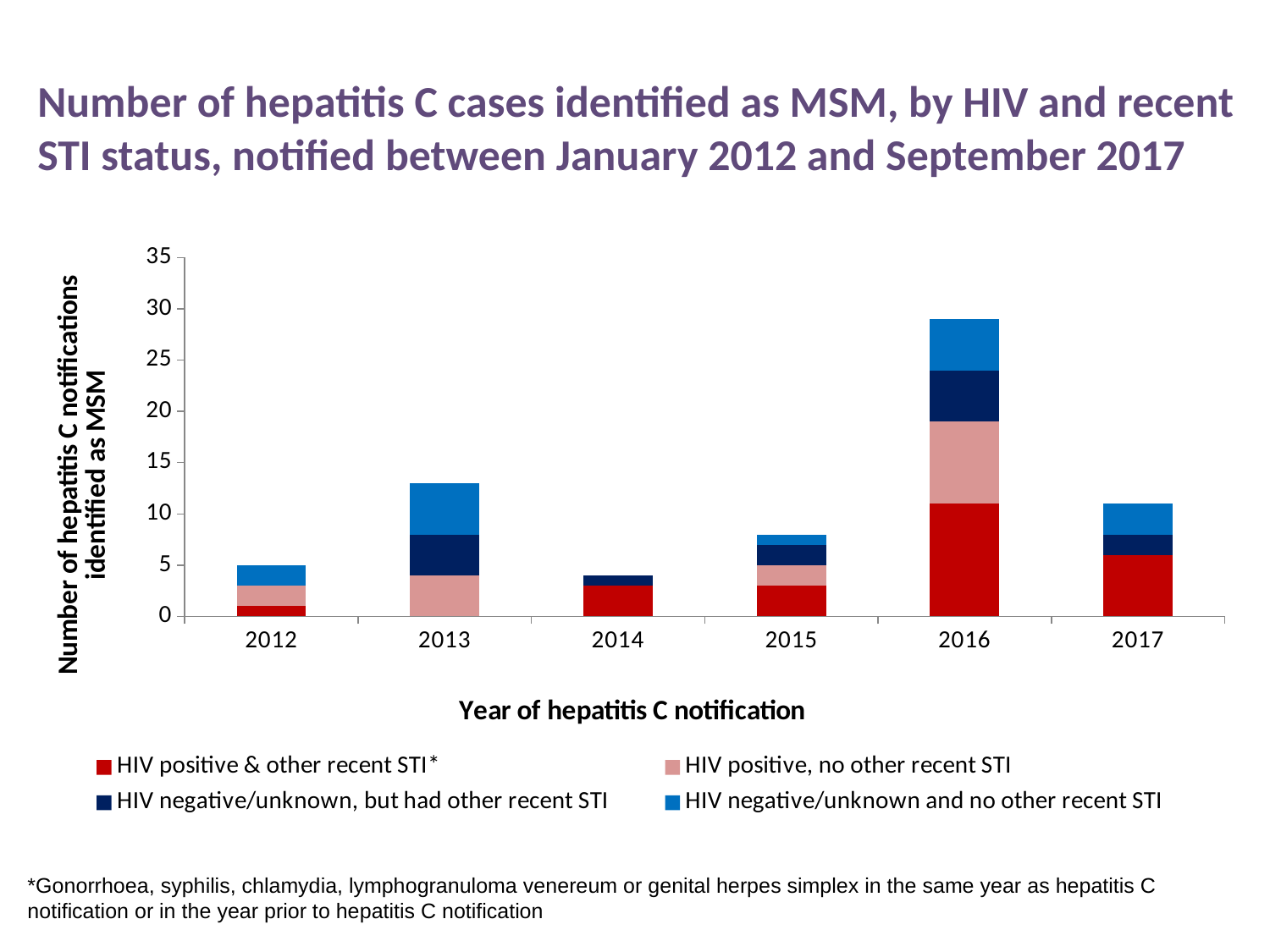
What is the title of the x axis of the chart? Year of hepatitis C notification Is the total number of notifications in 2014 greater or less than 5? less Is the total number of notifications in 2013 greater or less than 10? greater Which year has a larger total number of notifications, 2013 or 2015? 2013 Which legend entry is shown in red in the chart? HIV positive & other recent STI* Which year has the highest total number of hepatitis C notifications identified as MSM? 2016 How many series does the chart's legend list? 4 How many years are shown on the x axis of the chart? 6 Is the total number of notifications in 2015 greater or less than 10? less What kind of chart is shown on the slide? Stacked bar chart Which year has the lowest total number of hepatitis C notifications identified as MSM? 2014